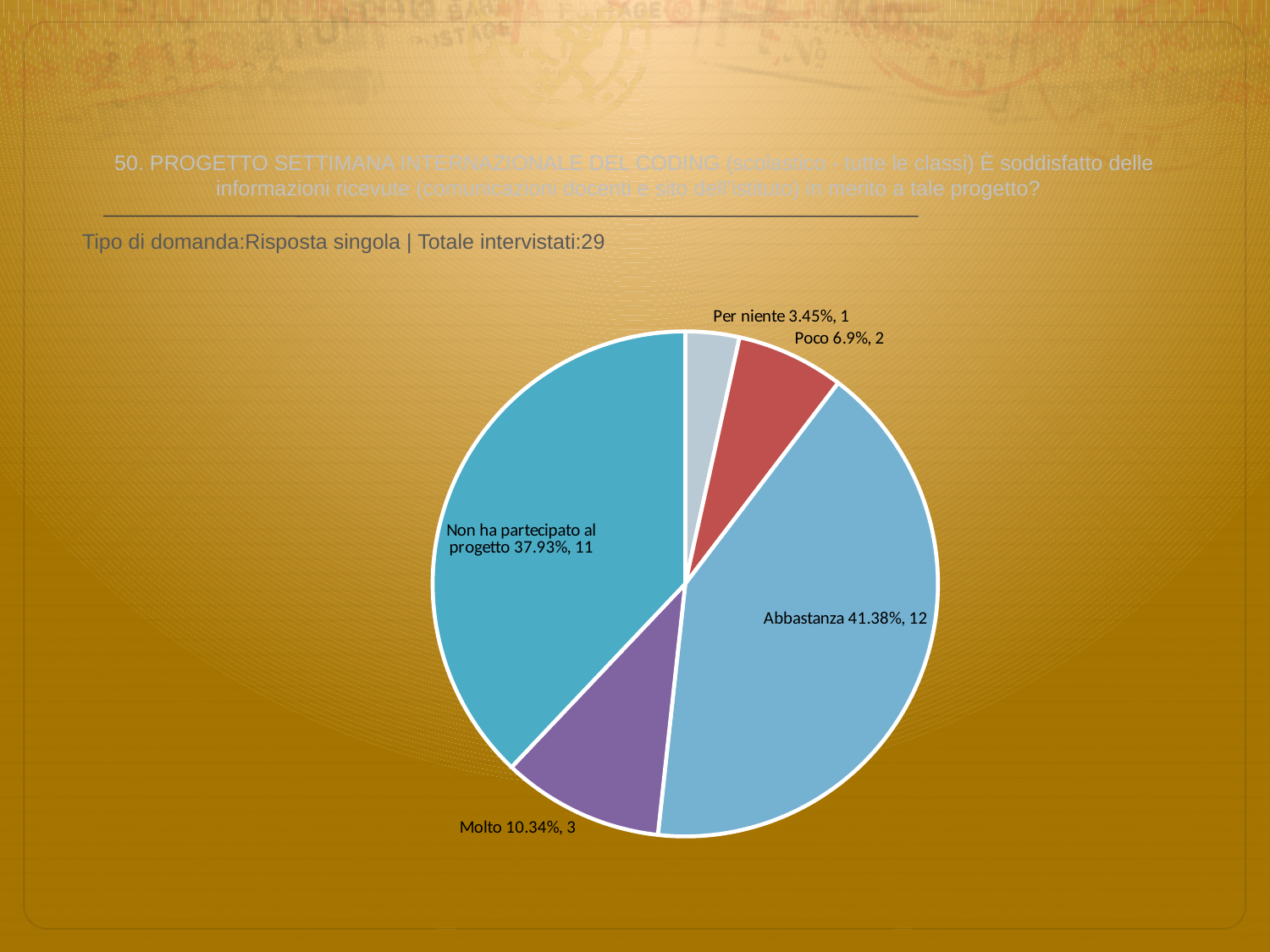
What is the total number of respondents (Totale intervistati) stated on the slide? 29 Which has more respondents, 'Molto' or 'Poco'? Molto Which category has the largest slice of the pie? Abbastanza How many respondents chose 'Non ha partecipato al progetto'? 11 What percentage share does the 'Abbastanza' slice have? 41.38% What is the difference in respondent count between 'Abbastanza' and 'Non ha partecipato al progetto'? 1 How many slices does the pie chart have? 5 What percentage share does the 'Molto' slice have? 10.34% How many respondents chose 'Poco'? 2 What percentage share does the 'Per niente' slice have? 3.45% Which category has the smallest slice of the pie? Per niente What kind of chart is shown on the slide? pie chart